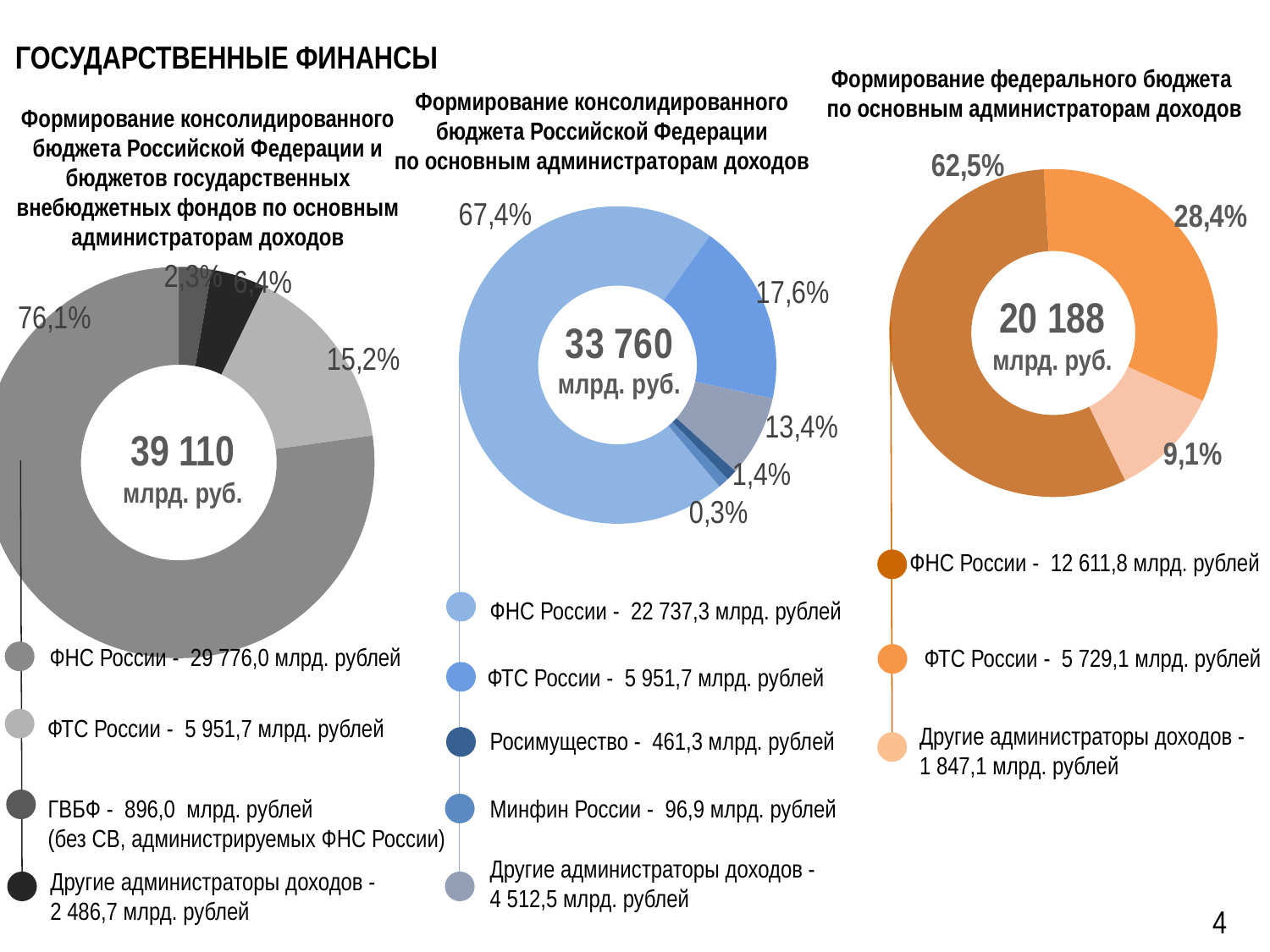
In the middle chart (Формирование консолидированного бюджета Российской Федерации по основным администраторам доходов), what share of the total does ФНС России account for? 67,4% In the middle chart, which administrator has the smallest share? Минфин России In the right chart, which administrator has the largest share? ФНС России In the left chart (consolidated budget and state extra-budgetary funds), what value is given for ФТС России in the legend? 5 951,7 млрд. рублей What is the total shown in the centre of the left chart? 39 110 млрд. руб. In the right chart (Формирование федерального бюджета по основным администраторам доходов), what is the total shown in the centre of the donut? 20 188 млрд. руб. How many donut charts are shown on the slide? 3 In the right chart, what is the difference in percentage points between the ФНС России share (62,5%) and the ФТС России share (28,4%)? 34,1 percentage points In the left chart, which is larger: the share of ГВБФ or the share of Другие администраторы доходов? Другие администраторы доходов What kind of chart is used on this slide? Donut (pie) chart In the middle chart, what value is given for Росимущество? 461,3 млрд. рублей How many categories does the legend of the middle chart list? 5